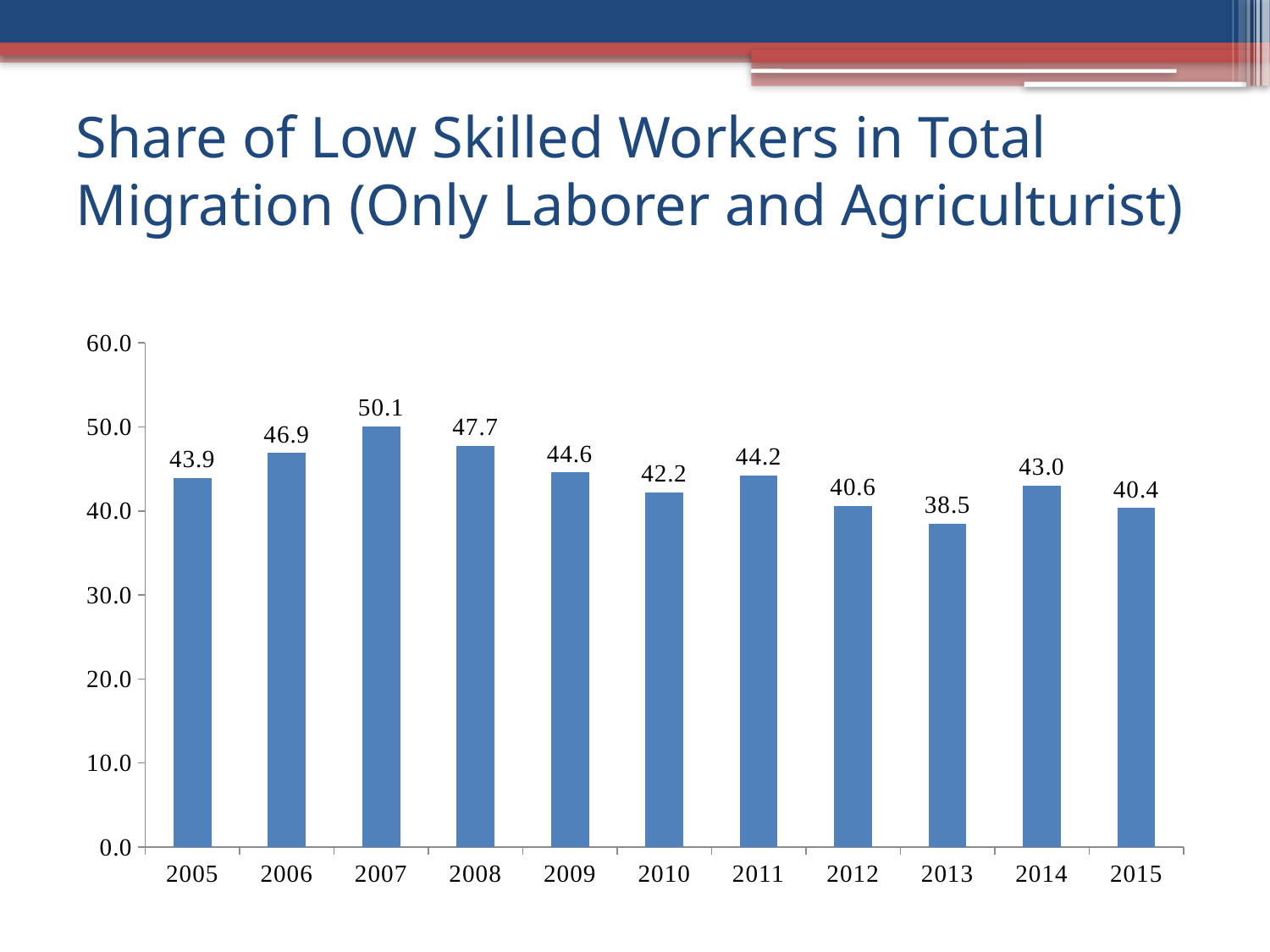
What is the value for 2010? 42.2 What is the value for 2013? 38.5 How many years are shown on the x axis? 11 What is the difference between the values for 2005 and 2006? 3.0 Which is larger, the value for 2008 or the value for 2009? 2008 Which year has the highest value? 2007 What is the value for 2007? 50.1 Is the value for 2012 greater or less than 50.0? less Which year has the lowest value? 2013 Do the values generally rise or fall from 2007 to 2013? fall What is the difference between the values for 2007 and 2013? 11.6 What kind of chart is this? bar chart